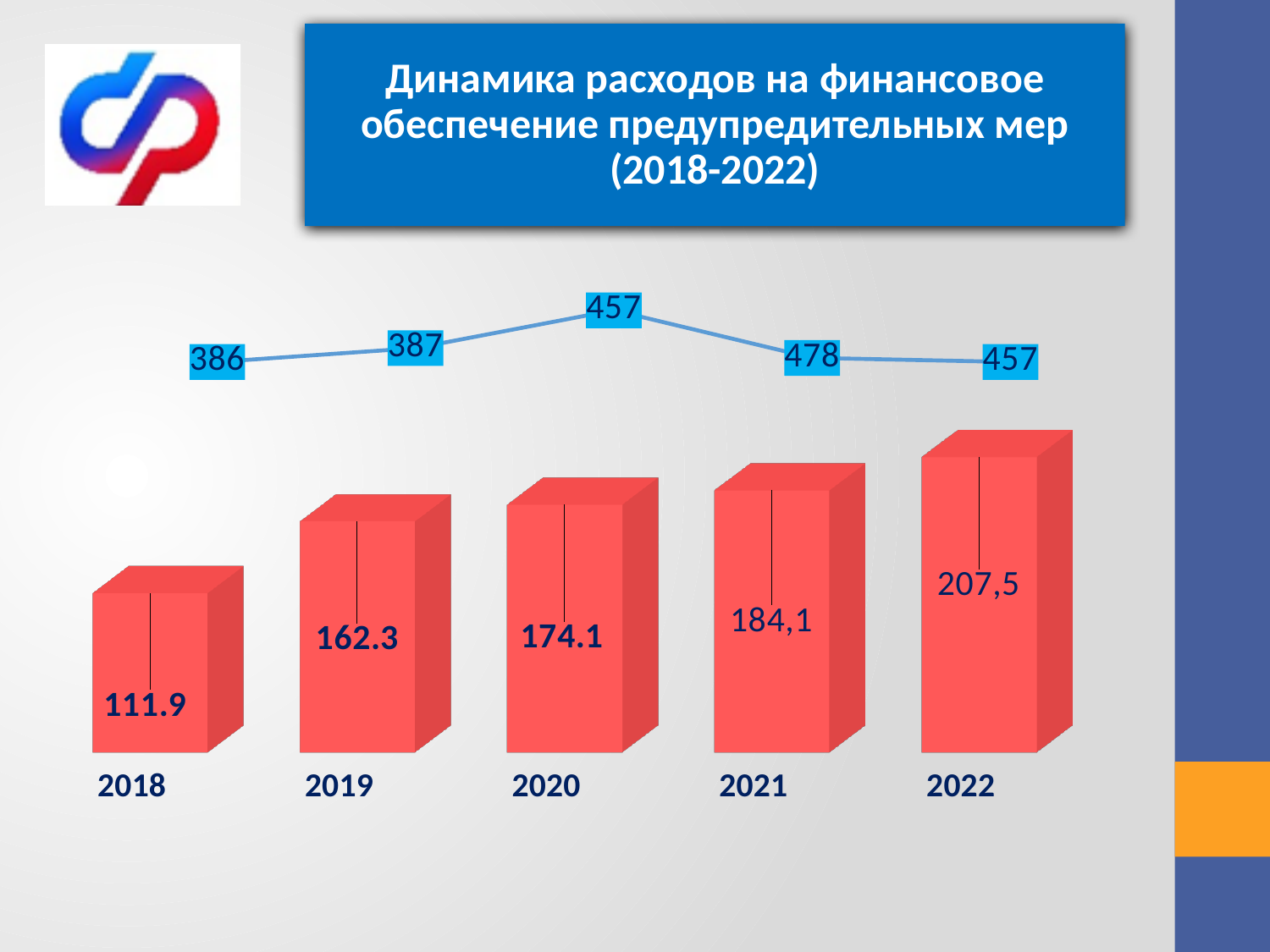
What is the difference between the line values for 2021 and 2018? 92 What is the bar value for 2018? 111.9 Do the bar values rise or fall from 2018 to 2022? rise What is the bar value for 2022? 207,5 Which year has the highest bar value? 2022 How many years are shown on the x axis? 5 What is the difference between the bar values for 2020 and 2019? 11.8 Which year has the lowest bar value? 2018 Which is larger, the bar value for 2019 or the bar value for 2021? 2021 What is the line value shown for 2018? 386 What is the line value shown for 2021? 478